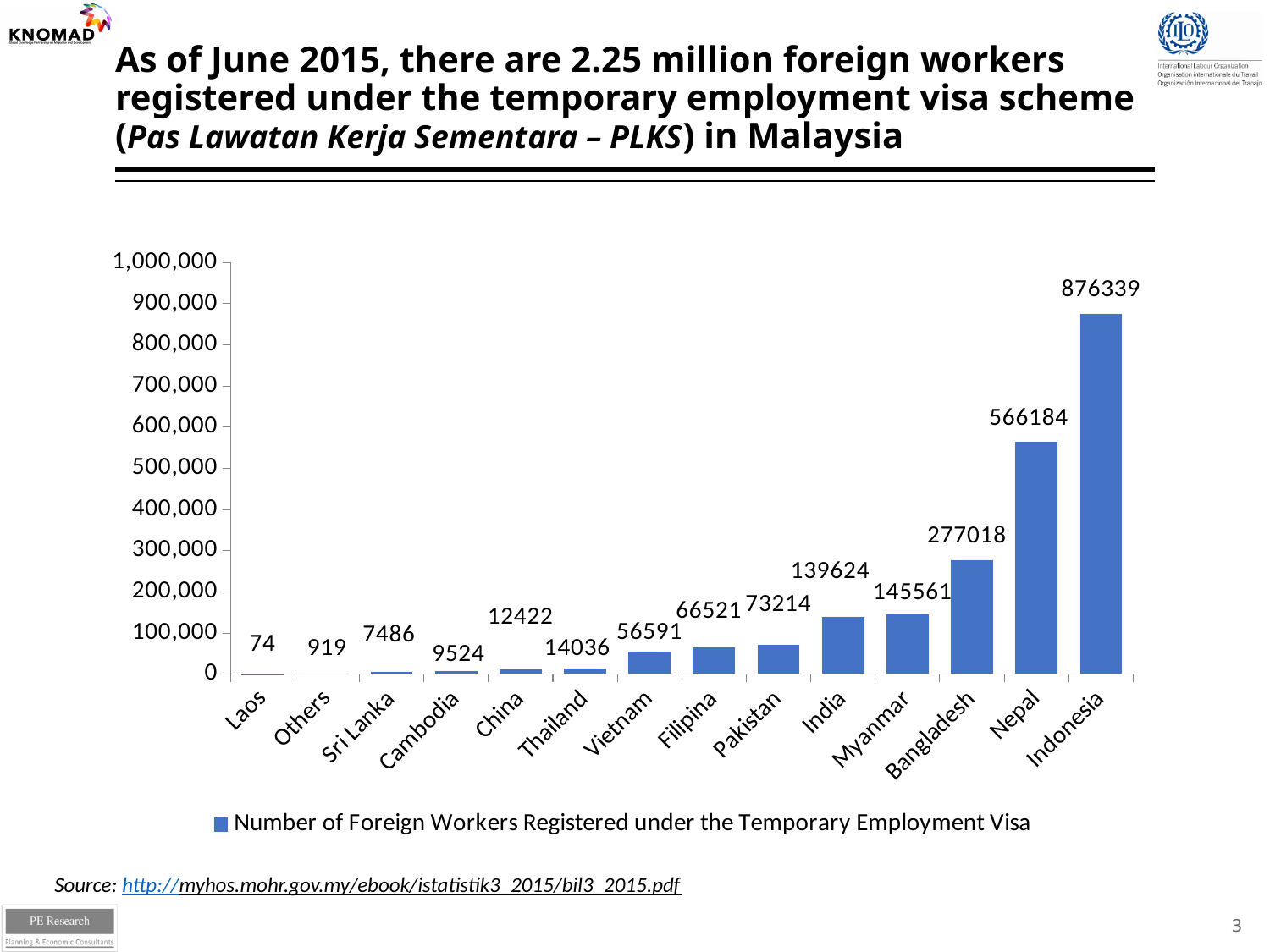
What is the difference between the values for Indonesia and Nepal? 310155 Which category has the lowest value on the chart? Laos What is the number of foreign workers registered for Nepal? 566184 Is the value for Nepal greater or less than 500,000? greater What kind of chart is shown on the slide? Bar chart How many categories are shown on the x axis? 14 What is the value shown for Myanmar? 145561 Which country has the highest number of registered foreign workers? Indonesia What is the number of foreign workers registered for Indonesia? 876339 How many series does the legend list? 1 What is the value shown for Laos? 74 Which is larger, the value for Bangladesh or the value for India? Bangladesh